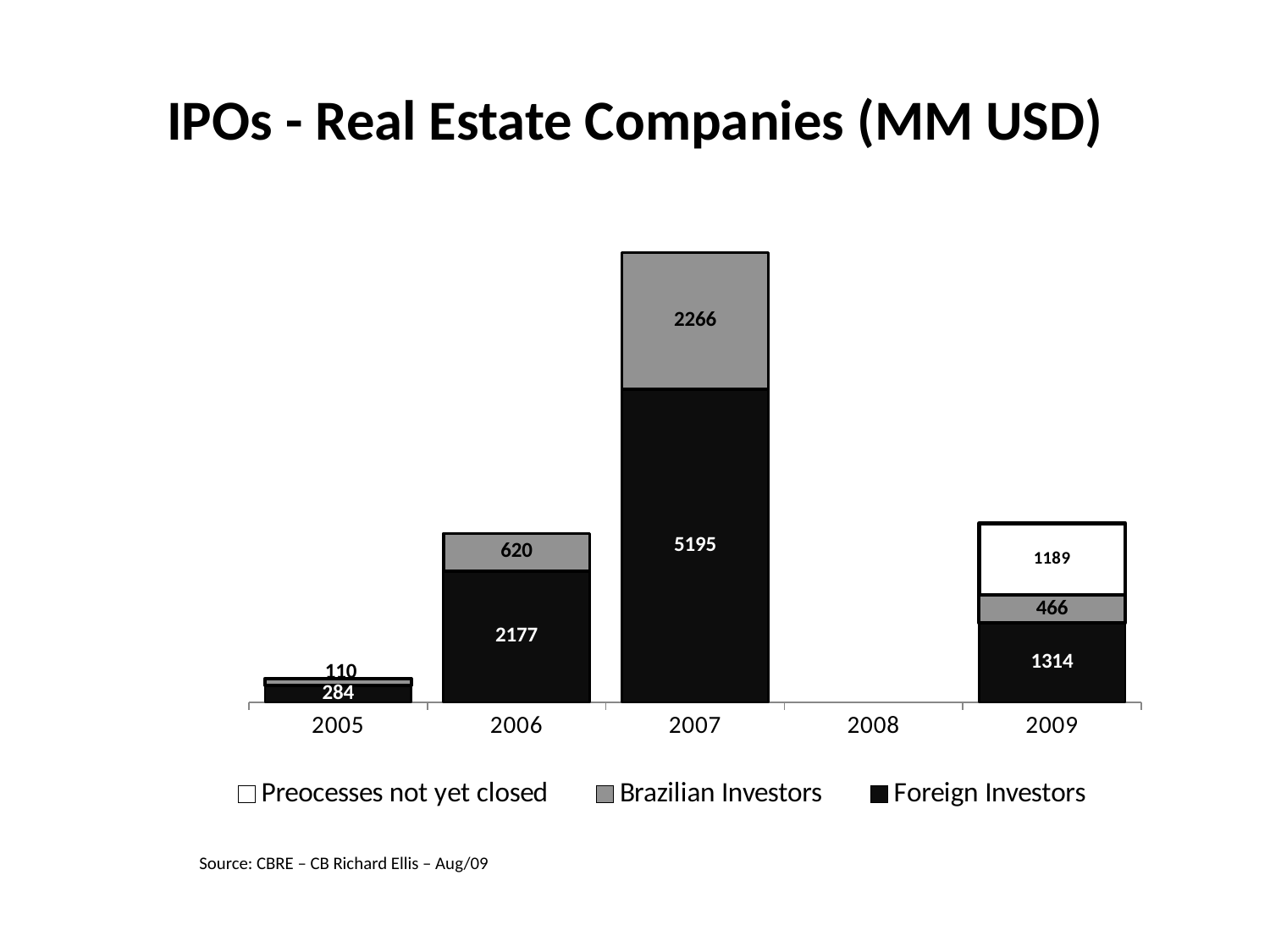
What is the total of the stacked bar for 2009? 2969 What kind of chart is shown on the slide? Stacked bar chart What is the value for Brazilian Investors in 2006? 620 What is the value for Preocesses not yet closed in 2009? 1189 Which year has the highest value for Foreign Investors? 2007 What is the value for Foreign Investors in 2005? 284 What is the total of the stacked bar for 2007? 7461 Which is larger: Brazilian Investors in 2009 or Brazilian Investors in 2006? Brazilian Investors in 2006 What is the difference between Foreign Investors in 2007 and Foreign Investors in 2006? 3018 How many series does the legend list? 3 What is the value for Foreign Investors in 2007? 5195 Which year has the lowest value for Brazilian Investors among the years with data? 2005